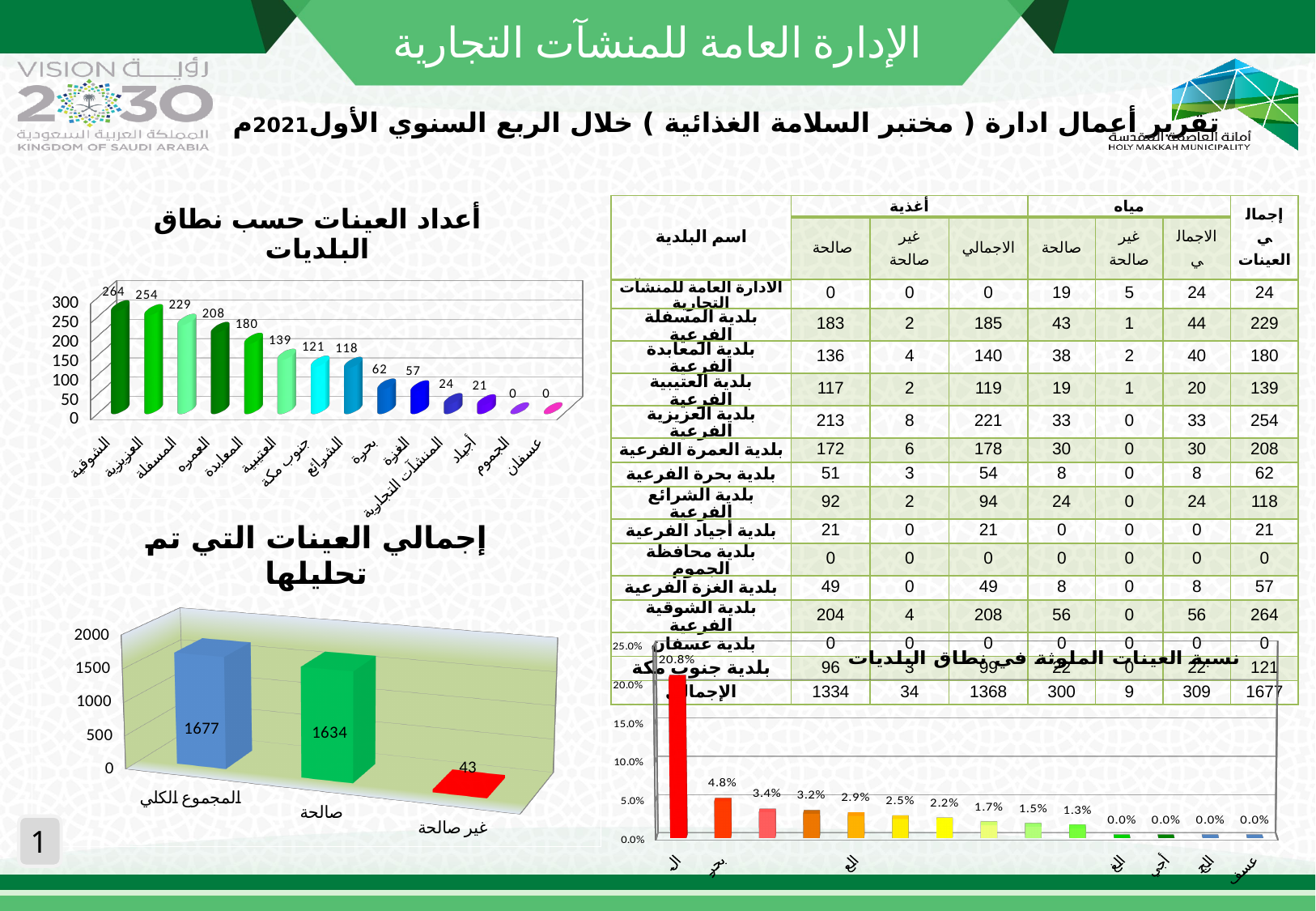
In the chart titled 'أعداد العينات حسب نطاق البلديات', which category has the highest value? الشوقية In the chart titled 'إجمالي العينات التي تم تحليلها', what is the difference between المجموع الكلي and صالحة? 43 In the chart titled 'أعداد العينات حسب نطاق البلديات', how many categories are shown on the x axis? 14 What kind of chart is the one titled 'إجمالي العينات التي تم تحليلها'? bar chart In the chart at the bottom right titled 'نسبة العينات الملوثة في نطاق البلديات', what is the highest value shown? 20.8% In the chart titled 'أعداد العينات حسب نطاق البلديات', what is the value for الشوقية? 264 In the chart titled 'إجمالي العينات التي تم تحليلها', what is the value for غير صالحة? 43 In the chart titled 'أعداد العينات حسب نطاق البلديات', which is larger, the value for بحرة or the value for الغزة? بحرة In the chart titled 'أعداد العينات حسب نطاق البلديات', do the values rise or fall from left to right? fall In the chart titled 'أعداد العينات حسب نطاق البلديات', what is the difference between the values for العزيزية and المسفلة? 25 In the chart titled 'إجمالي العينات التي تم تحليلها', what is the value for صالحة? 1634 In the chart titled 'أعداد العينات حسب نطاق البلديات', what is the value for المعابدة? 180